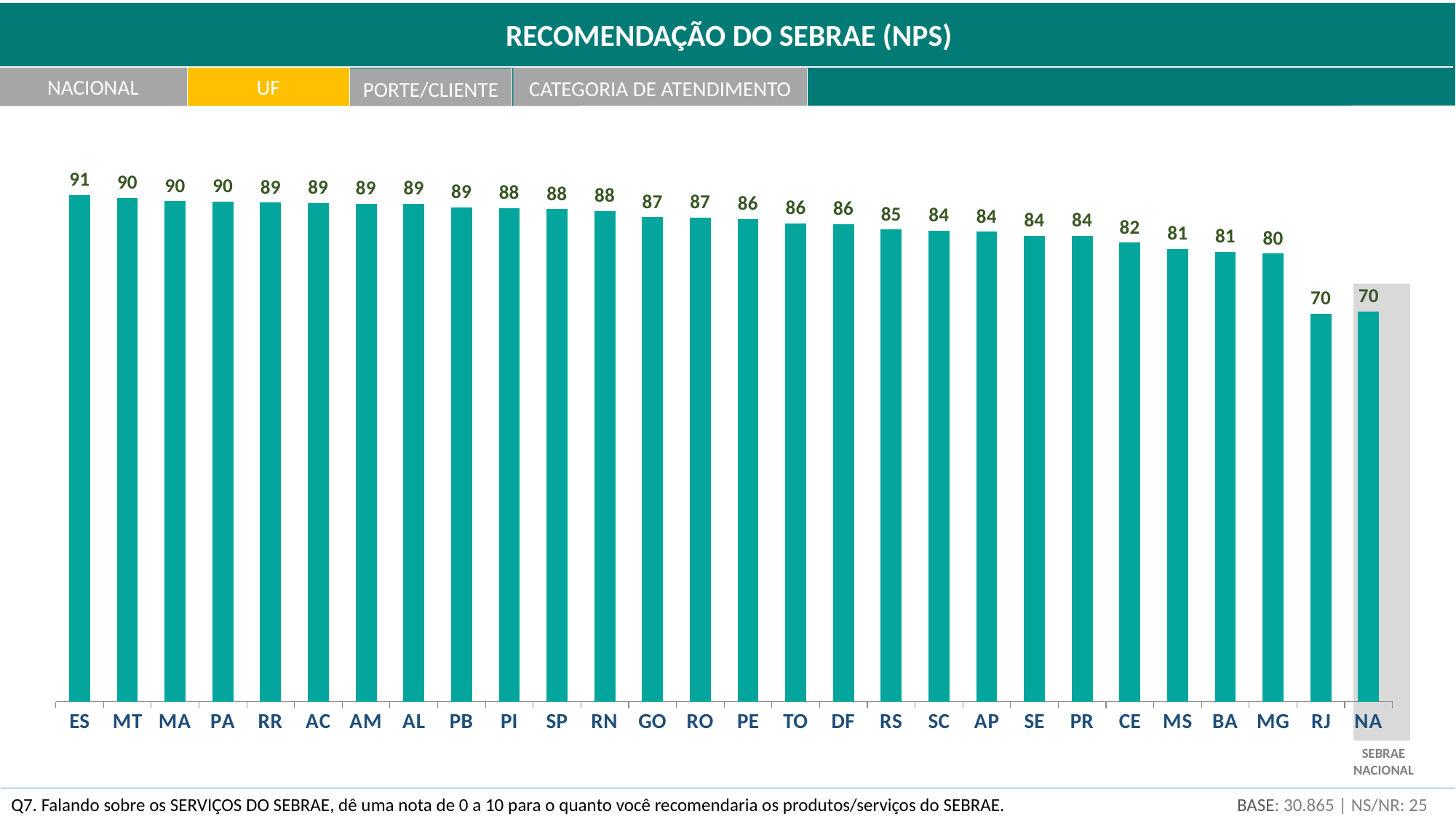
What is the NPS value for SP? 88 What is the NPS value for NA (SEBRAE NACIONAL)? 70 What is the difference between the NPS values for ES and RJ? 21 Which category has the highest NPS value? ES What is the difference between the NPS values for GO and CE? 5 How many categories are shown on the x axis of the chart? 28 What is the NPS value for RJ? 70 Which has a higher NPS value, MT or BA? MT What kind of chart is shown on the slide? bar chart What is the NPS value for MG? 80 Do the values generally rise or fall from left to right along the x axis? fall What is the NPS value for ES? 91